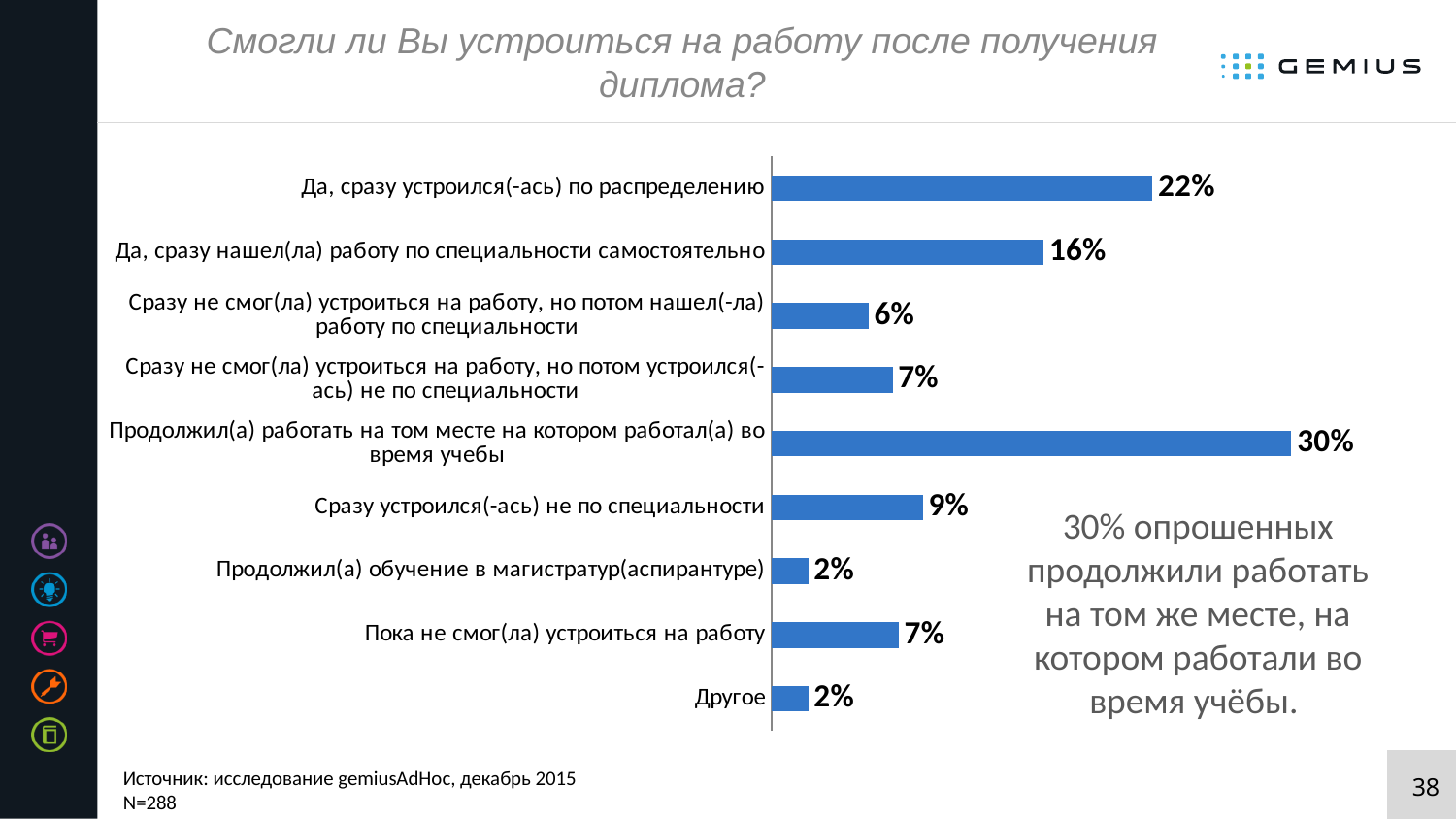
What is the difference between the values for "Продолжил(а) работать на том месте на котором работал(а) во время учебы" and "Да, сразу устроился(-ась) по распределению"? 8% What is the difference between the values for "Да, сразу нашел(ла) работу по специальности самостоятельно" and "Сразу не смог(ла) устроиться на работу, но потом устроился(-ась) не по специальности"? 9% What is the value for "Пока не смог(ла) устроиться на работу"? 7% What is the sample size (N) stated on the slide? N=288 What is the value for "Да, сразу устроился(-ась) по распределению"? 22% What type of chart is shown on the slide? bar chart What is the value for "Да, сразу нашел(ла) работу по специальности самостоятельно"? 16% Which is larger: the value for "Сразу не смог(ла) устроиться на работу, но потом нашел(-ла) работу по специальности" or for "Сразу устроился(-ась) не по специальности"? Сразу устроился(-ась) не по специальности Which category has the highest value? Продолжил(а) работать на том месте на котором работал(а) во время учебы How many categories are shown in the chart? 9 What is the value for "Сразу устроился(-ась) не по специальности"? 9% What is the value for "Продолжил(а) обучение в магистратур(аспирантуре)"? 2%